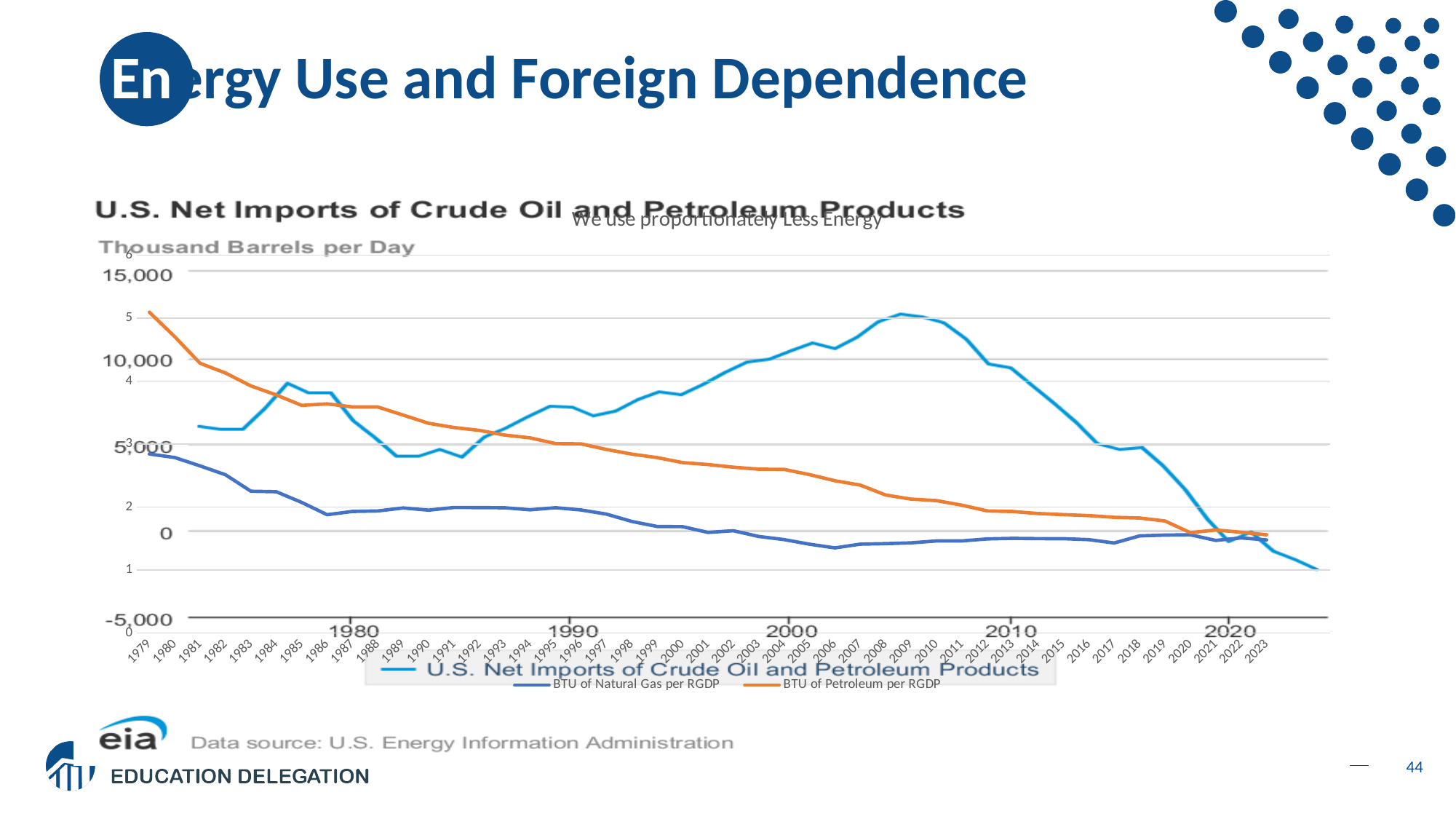
How many series does the legend of the 'We use proportionately Less Energy' chart list? 2 What is the title of the EIA chart on the slide? U.S. Net Imports of Crude Oil and Petroleum Products In the 'We use proportionately Less Energy' chart, does the BTU of Petroleum per RGDP series rise or fall from 1979 to 2023? fall In the 'We use proportionately Less Energy' chart, is the value for BTU of Petroleum per RGDP in 1979 greater or less than 4? greater In the 'U.S. Net Imports of Crude Oil and Petroleum Products' chart, is the value around 2005 greater or less than 10,000? greater In the 'We use proportionately Less Energy' chart, which series has the larger value in 1979, BTU of Natural Gas per RGDP or BTU of Petroleum per RGDP? BTU of Petroleum per RGDP What unit is shown on the y axis of the 'U.S. Net Imports of Crude Oil and Petroleum Products' chart? Thousand Barrels per Day In the 'U.S. Net Imports of Crude Oil and Petroleum Products' chart, is the value in 2020 greater or less than 5,000? less How many years are labelled on the x axis of the 'We use proportionately Less Energy' chart? 45 What kind of chart is the 'We use proportionately Less Energy' chart? line chart In the 'U.S. Net Imports of Crude Oil and Petroleum Products' chart, does the line rise or fall between 2010 and 2020? fall